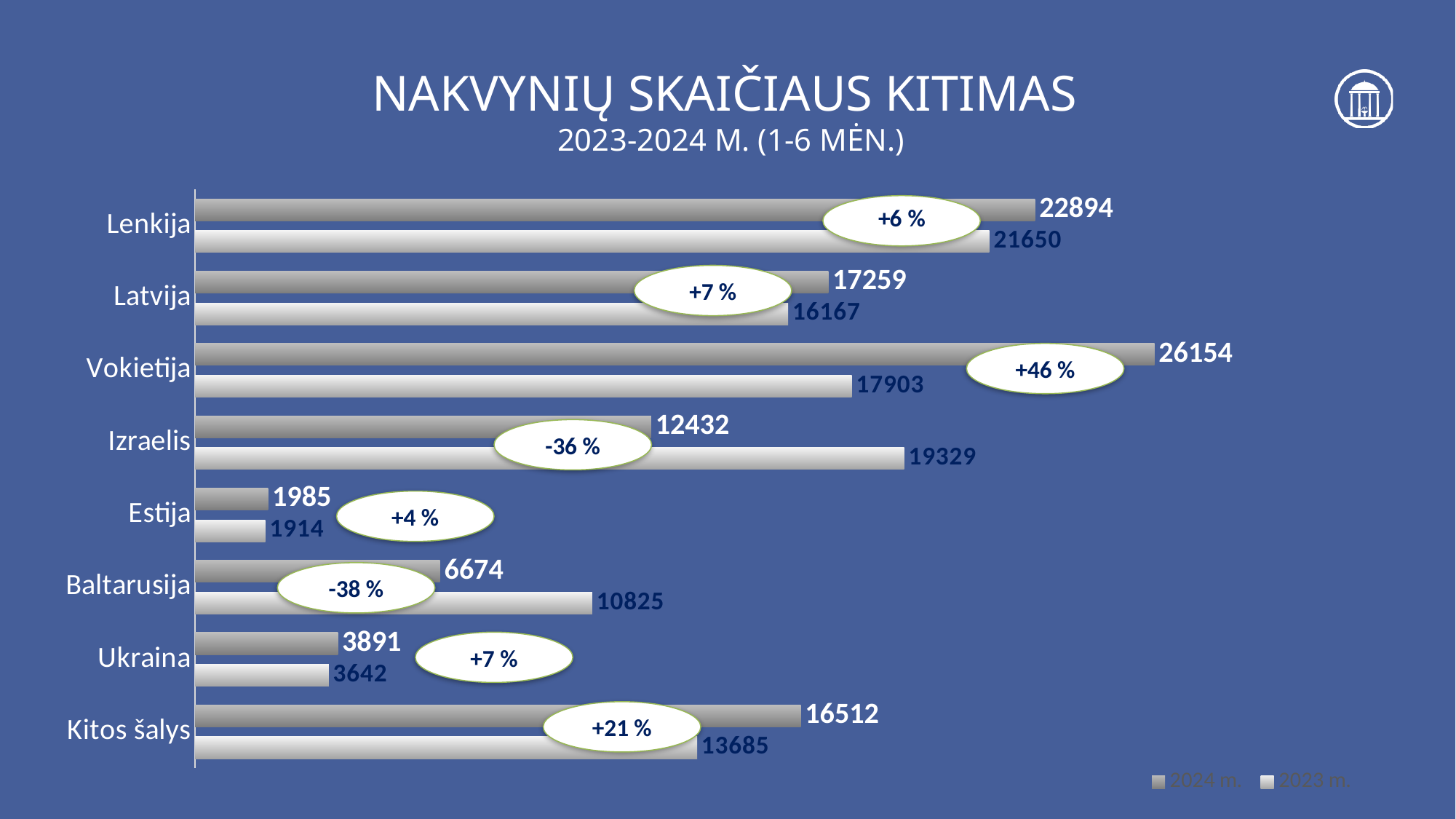
Which is larger for Izraelis, the 2024 m. value or the 2023 m. value? 2023 m. What is the 2024 m. value for Vokietija? 26154 What is the title of the chart? NAKVYNIŲ SKAIČIAUS KITIMAS 2023-2024 M. (1-6 MĖN.) Which category has the highest 2024 m. value? Vokietija What is the 2024 m. value for Kitos šalys? 16512 Which category has the lowest 2023 m. value? Estija What kind of chart is shown on the slide? Bar chart What is the 2023 m. value for Izraelis? 19329 How many categories are shown on the chart? 8 What percentage change is shown for Baltarusija? -38 % How many series does the legend list? 2 What is the difference between the 2024 m. and 2023 m. values for Lenkija? 1244